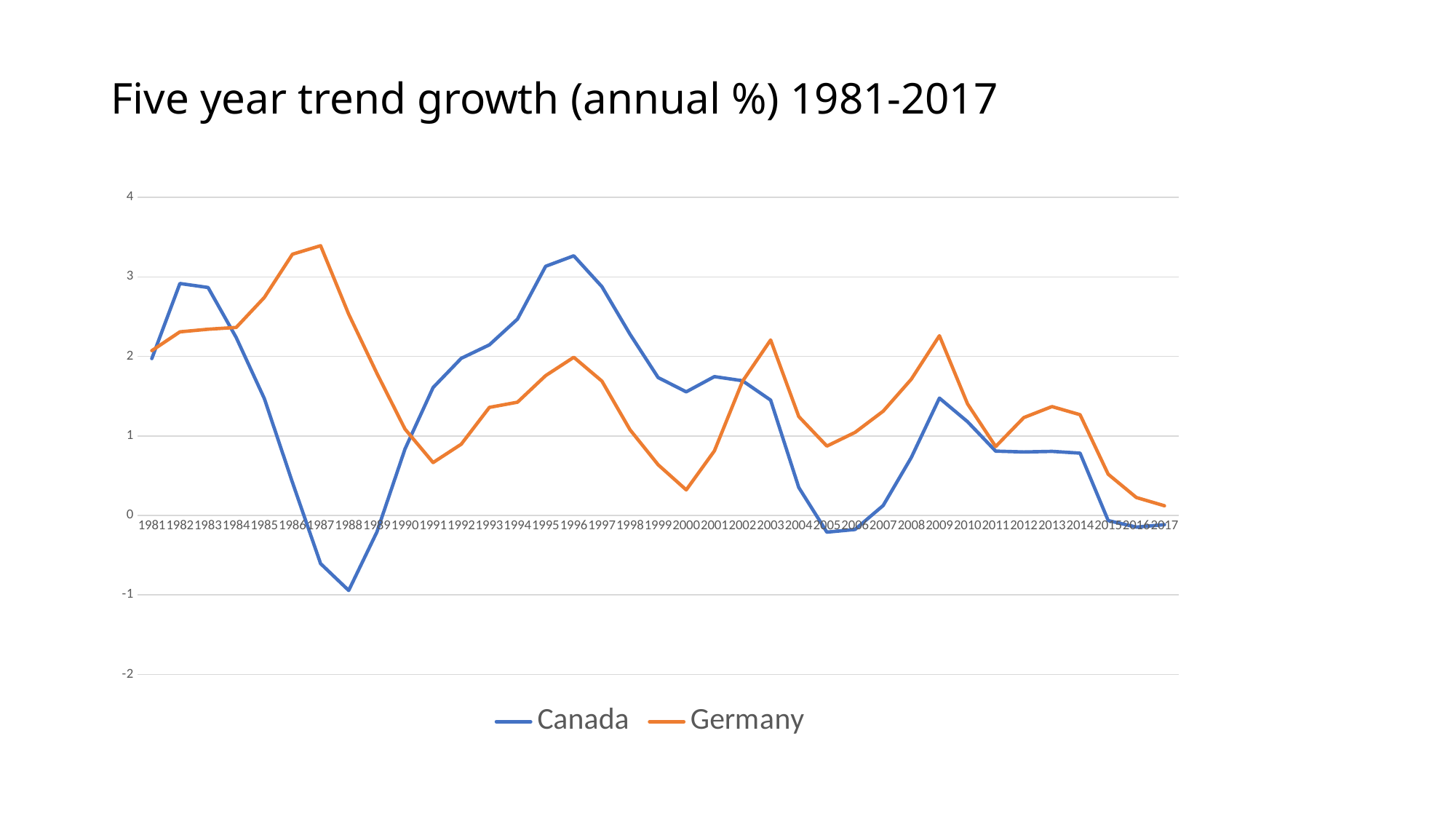
What kind of chart is shown on the slide? line chart Is the value for Germany in 2000 greater or less than 1? less In 1987, which series has the larger value, Canada or Germany? Germany In 1996, which series has the larger value, Canada or Germany? Canada Does the Canada series rise or fall between 1985 and 1988? fall Is the value for Canada in 1988 greater or less than 0? less Is the value for Germany in 1987 greater or less than 3? greater What is the title of the chart? Five year trend growth (annual %) 1981-2017 How many years are plotted along the x axis? 37 How many series does the legend list? 2 In which year does the Canada series reach its lowest value? 1988